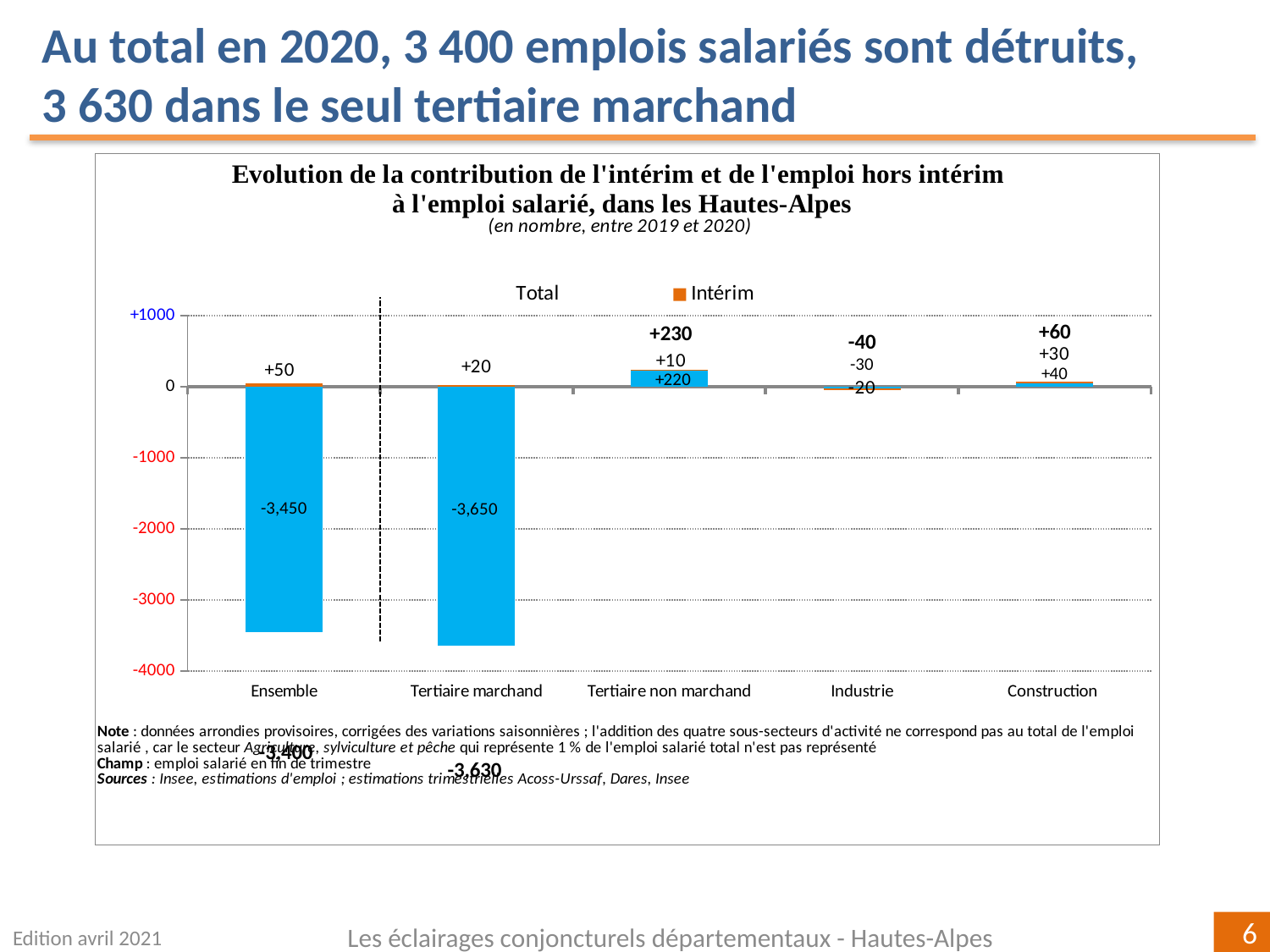
What is the total value shown above Tertiaire non marchand? +230 Which category has the highest total value? Tertiaire non marchand What value is labelled on the blue bar for Tertiaire marchand? -3,650 What is the Intérim value shown for Ensemble? +50 Which category has the lowest blue bar? Tertiaire marchand What is the difference between the Intérim value for Ensemble and the Intérim value for Tertiaire marchand? 30 What is the Intérim value shown for Construction? +30 What is the Intérim value shown for Industrie? -30 What is the total value printed for Ensemble? -3,400 What kind of chart is shown on the slide? Bar chart How many categories are shown on the x axis? 5 Which is larger, the blue bar value for Ensemble or for Tertiaire marchand? Ensemble